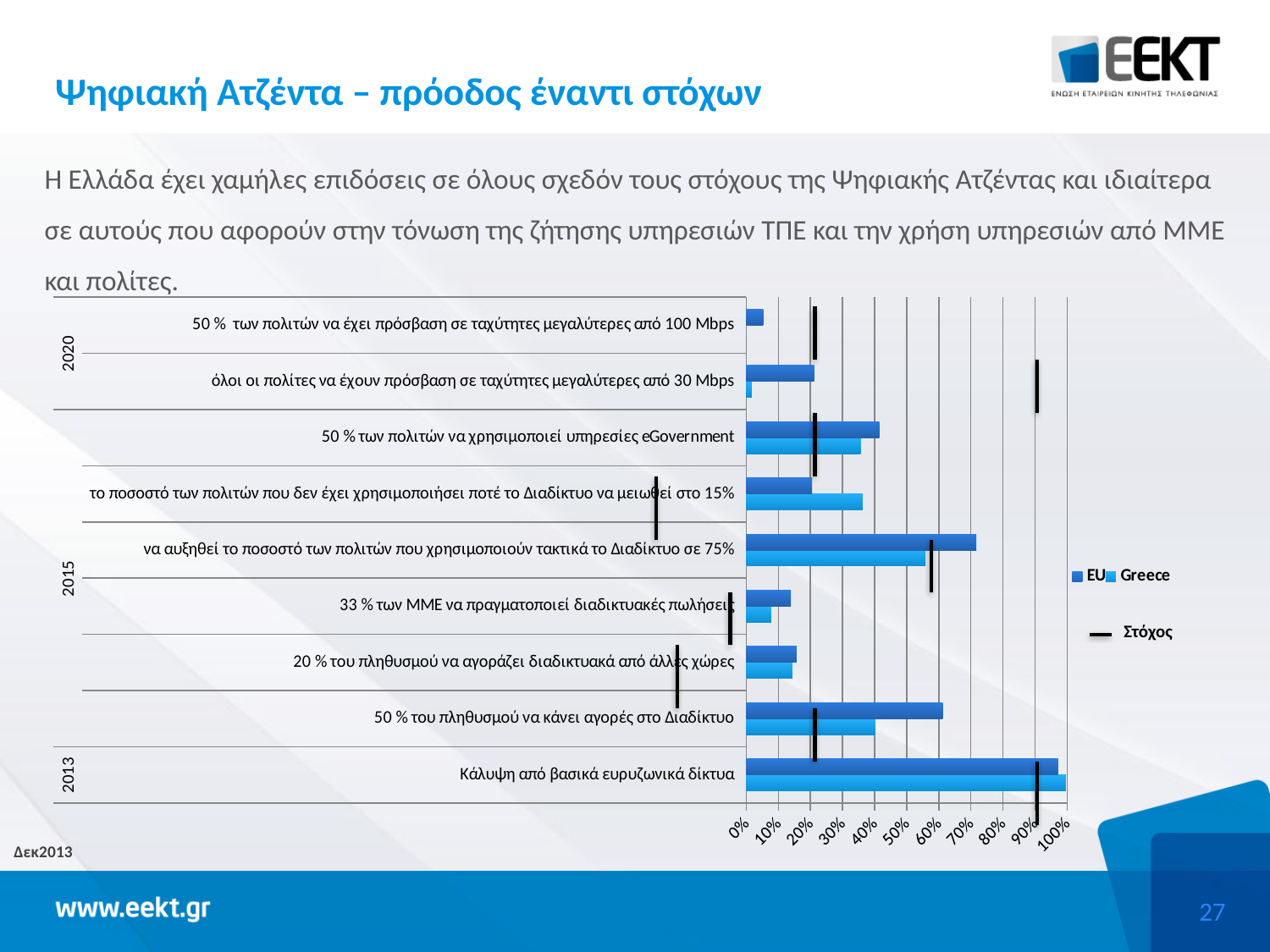
Which legend entry is shown as a black marker rather than a bar? Στόχος For 'το ποσοστό των πολιτών που δεν έχει χρησιμοποιήσει ποτέ το Διαδίκτυο να μειωθεί στο 15%', which is larger, the EU value or the Greece value? Greece Which category has the highest value for Greece? Κάλυψη από βασικά ευρυζωνικά δίκτυα Which category has the lowest value for Greece? 50 % των πολιτών να έχει πρόσβαση σε ταχύτητες μεγαλύτερες από 100 Mbps For 'να αυξηθεί το ποσοστό των πολιτών που χρησιμοποιούν τακτικά το Διαδίκτυο σε 75%', which is larger, the EU value or the Greece value? EU Is the EU value for '50 % του πληθυσμού να κάνει αγορές στο Διαδίκτυο' greater or less than 50%? greater Is the EU value for '50 % των πολιτών να χρησιμοποιεί υπηρεσίες eGovernment' greater or less than 50%? less Which category has the lowest value for EU? 50 % των πολιτών να έχει πρόσβαση σε ταχύτητες μεγαλύτερες από 100 Mbps How many series does the chart legend list? 3 How many categories (targets) are plotted on the chart? 9 Is the Greece value for 'Κάλυψη από βασικά ευρυζωνικά δίκτυα' greater or less than 90%? greater What kind of chart is shown on the slide? bar chart